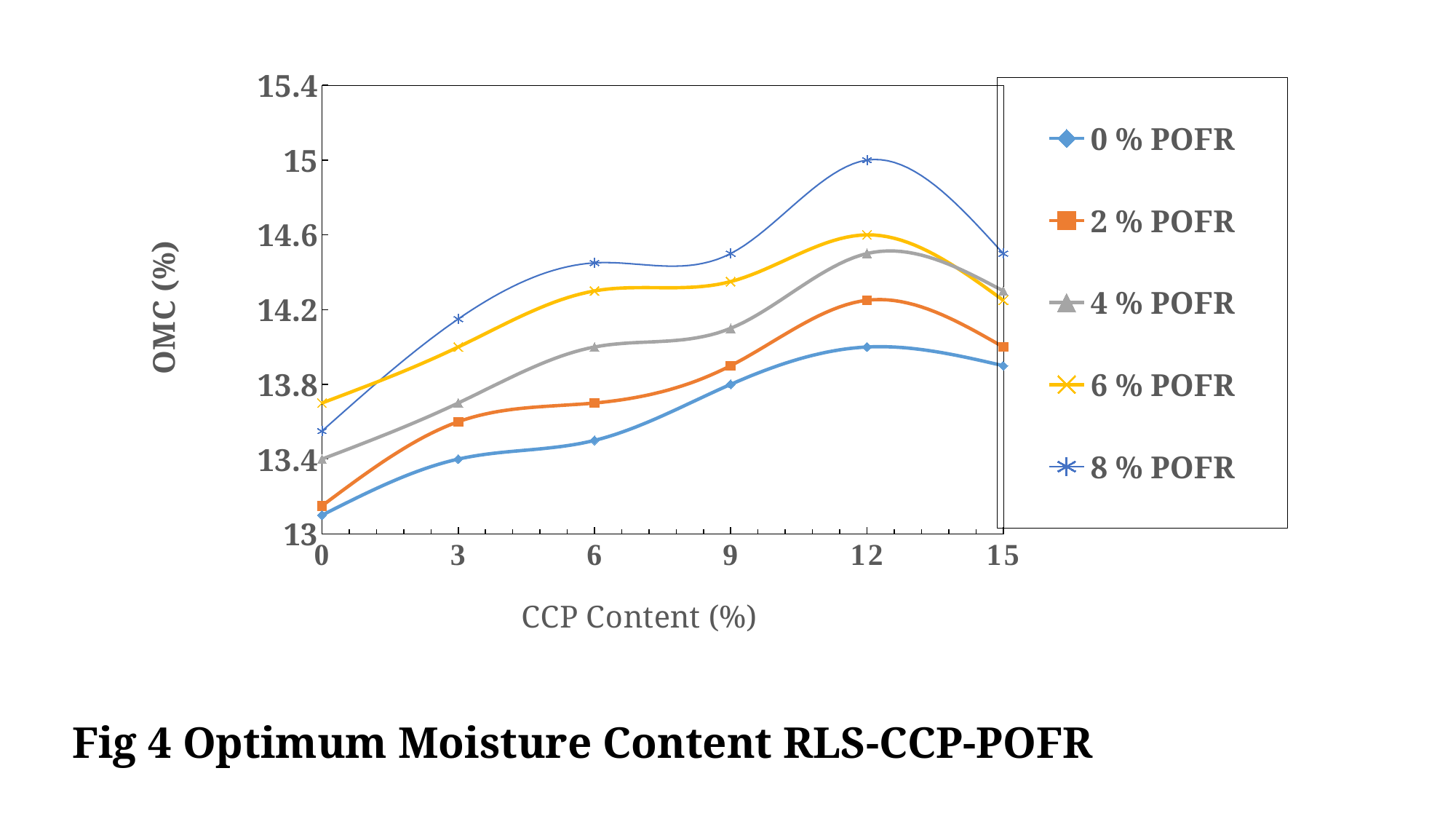
Is the OMC value for 8 % POFR at 6% CCP Content greater or less than 14.2? greater What is the label of the y axis? OMC (%) How many CCP Content values are plotted along the x axis? 6 What kind of chart is shown on the slide? line chart Which series has the highest OMC at 12% CCP Content? 8 % POFR What is the OMC value for 8 % POFR at 12% CCP Content? 15 Which series has the lowest OMC at 0% CCP Content? 0 % POFR Is the OMC value for 0 % POFR at 0% CCP Content greater or less than 13.4? less What is the OMC value for 0 % POFR at 9% CCP Content? 13.8 What is the OMC value for 4 % POFR at 0% CCP Content? 13.4 At 15% CCP Content, which is larger: the OMC for 8 % POFR or for 0 % POFR? 8 % POFR How many series does the legend list? 5